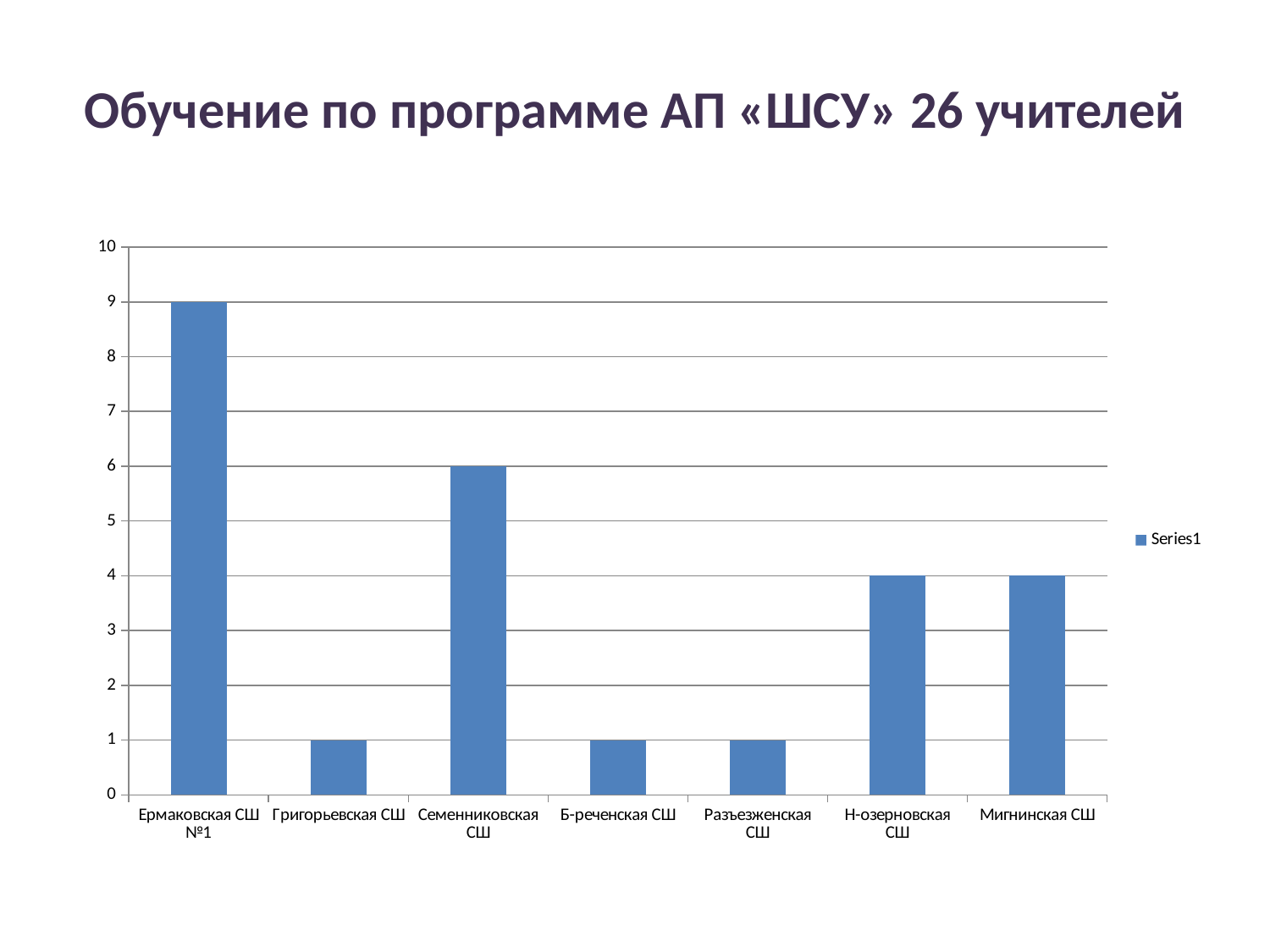
What is the value for Н-озерновская СШ? 4 What is the title of the slide? Обучение по программе АП «ШСУ» 26 учителей Which is larger, the value for Семенниковская СШ or the value for Мигнинская СШ? Семенниковская СШ What is the difference between the values for Ермаковская СШ №1 and Семенниковская СШ? 3 What is the value for Семенниковская СШ? 6 Is the value for Ермаковская СШ №1 greater or less than 8? greater How many schools (categories) are shown on the x axis? 7 What is the value for Ермаковская СШ №1? 9 What is the value for Григорьевская СШ? 1 What type of chart is shown on the slide? Bar chart How many series does the legend list? 1 Which school has the highest value? Ермаковская СШ №1